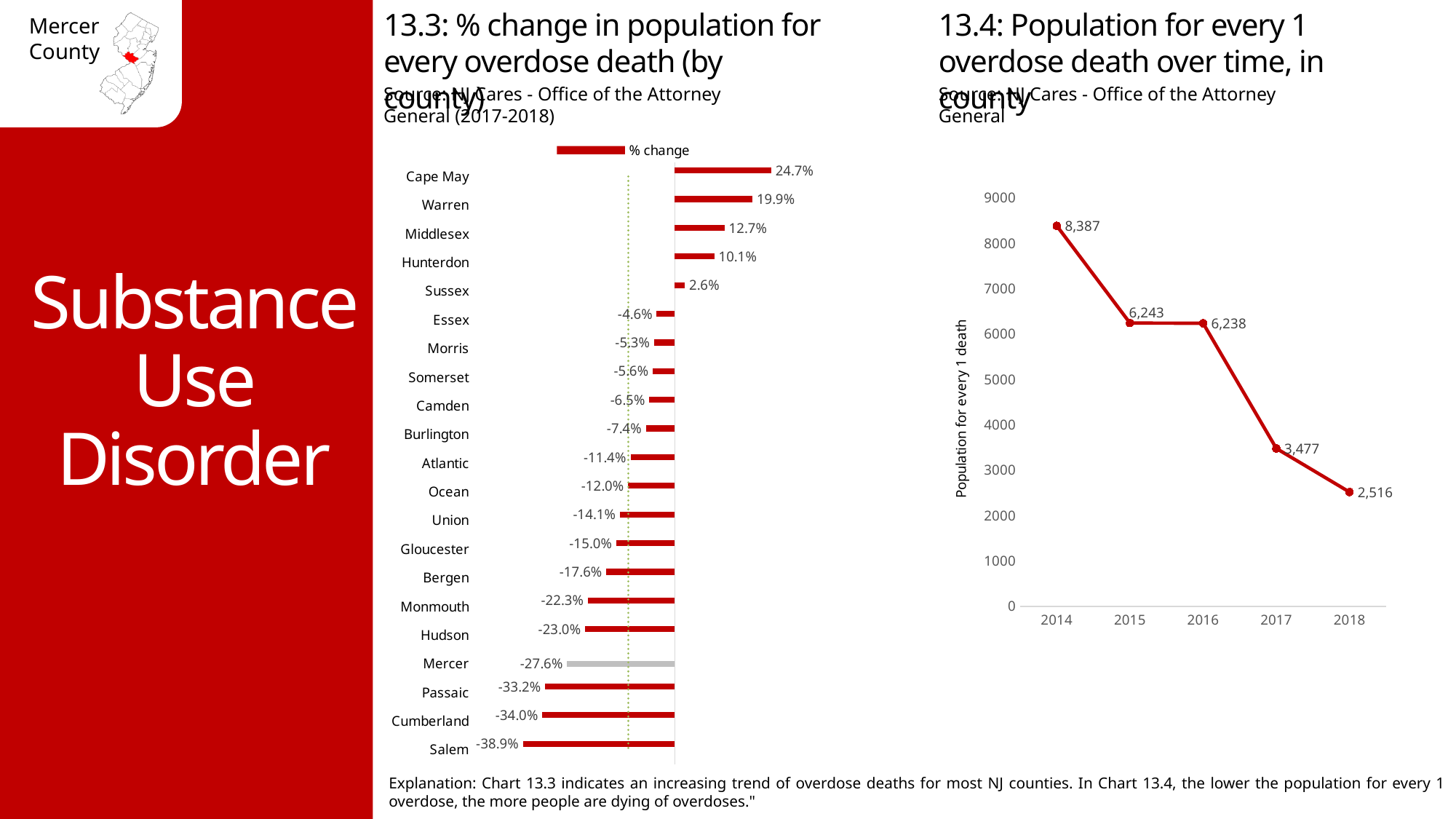
In chart 13.4, what is the population for every 1 overdose death in 2014? 8,387 In chart 13.4, does the population for every 1 overdose death rise or fall from 2014 to 2018? Fall In chart 13.3, which county has the highest % change? Cape May In chart 13.4, how many years are plotted? 5 In chart 13.3, which has a larger % change, Warren or Middlesex? Warren In chart 13.3, what is the difference in percentage points between Mercer (-27.6%) and Salem (-38.9%)? 11.3 percentage points What type of chart is chart 13.3? Bar chart In chart 13.3, what is the % change for Hunterdon? 10.1% In chart 13.3, which county has the lowest % change? Salem In chart 13.4, what is the difference between the 2014 value and the 2018 value? 5,871 In chart 13.3, what is the % change for Mercer? -27.6% In chart 13.3, how many counties are shown? 21